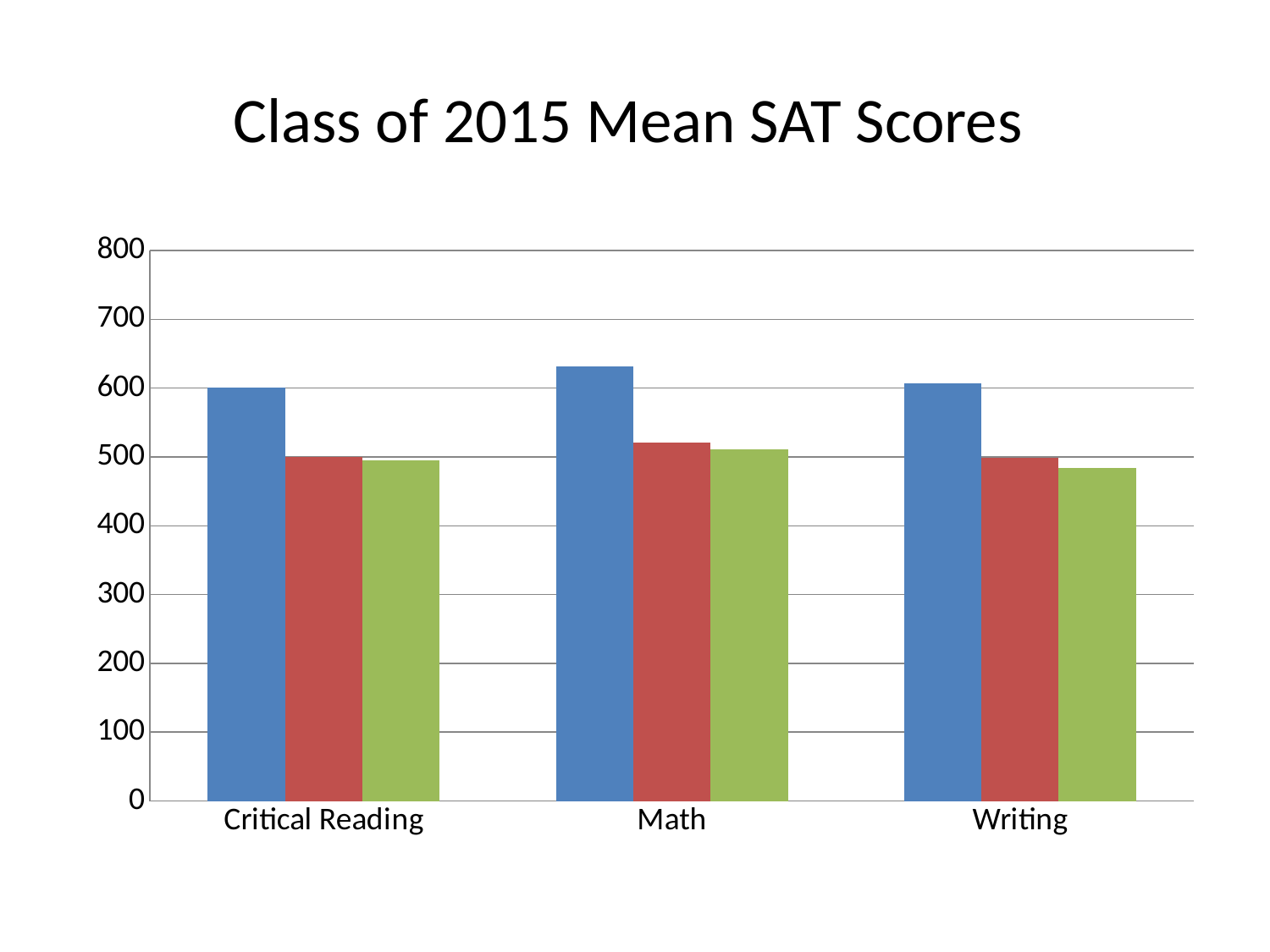
Is the red bar for Math greater or less than 500? greater How many categories are shown on the x axis? 3 Which category has the shortest green bar? Writing Which category has the tallest blue bar? Math What is the title of the chart? Class of 2015 Mean SAT Scores Is the green bar for Writing greater or less than 500? less Is the blue bar for Math greater or less than 600? greater What kind of chart is shown on the slide? Bar chart How many bars are shown for each category? 3 Which is larger, the blue bar for Math or the blue bar for Writing? Math Which is larger for Writing, the red bar or the green bar? The red bar